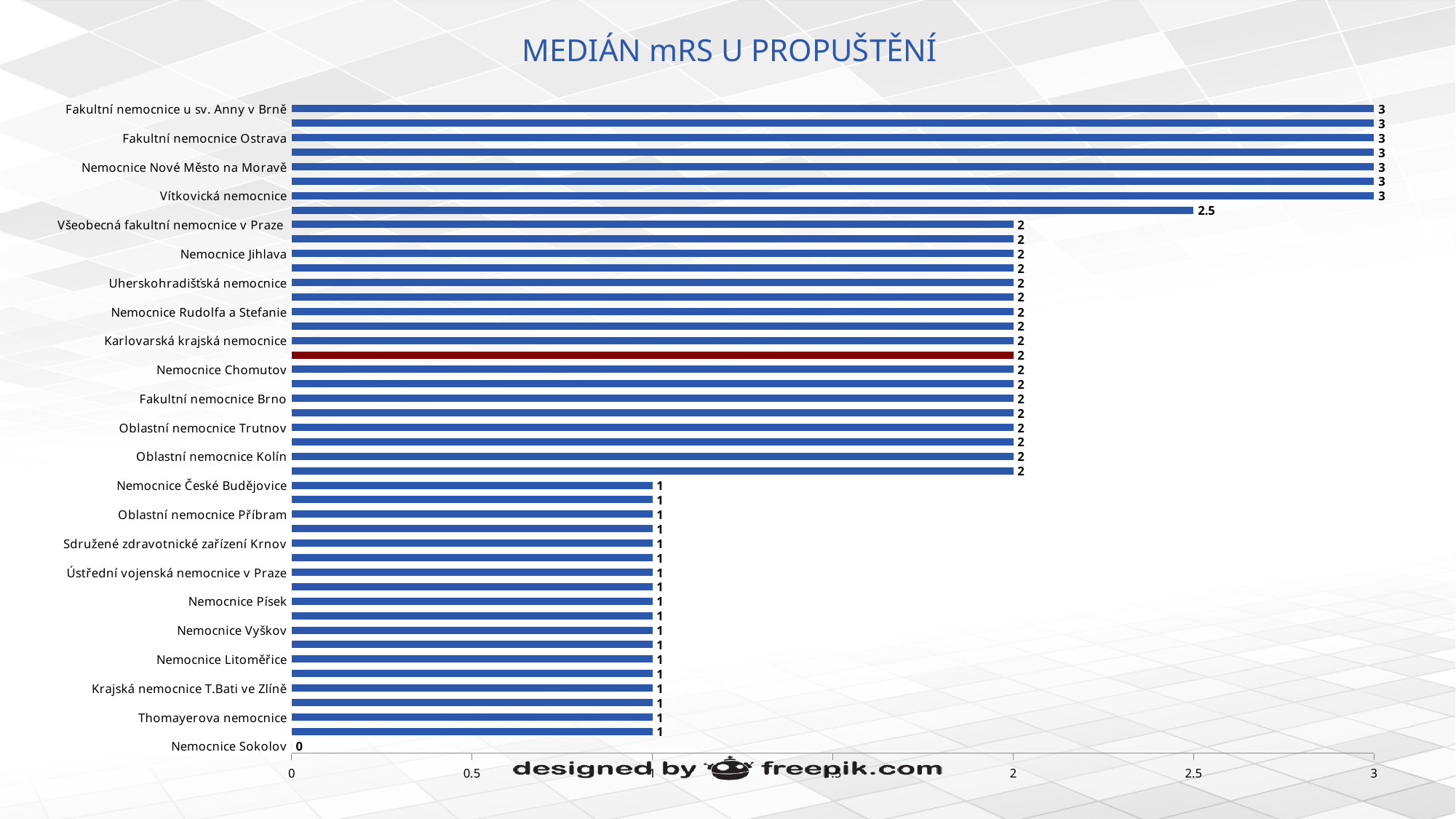
Is the value for Oblastní nemocnice Kolín greater or less than 1? greater What is the value for Nemocnice Písek? 1 What is the value for Fakultní nemocnice Ostrava? 3 Which hospital has the lowest value in the chart? Nemocnice Sokolov What is the value for Nemocnice Jihlava? 2 What is the difference between the values for Vítkovická nemocnice and Thomayerova nemocnice? 2 What is the value for Nemocnice Sokolov? 0 What colour is the single highlighted bar that differs from the others? red What is the title of the chart? MEDIÁN mRS U PROPUŠTĚNÍ What is the difference between the values for Nemocnice Nové Město na Moravě and Karlovarská krajská nemocnice? 1 Which has a larger value, Fakultní nemocnice Brno or Nemocnice Vyškov? Fakultní nemocnice Brno What type of chart is shown on the slide? bar chart